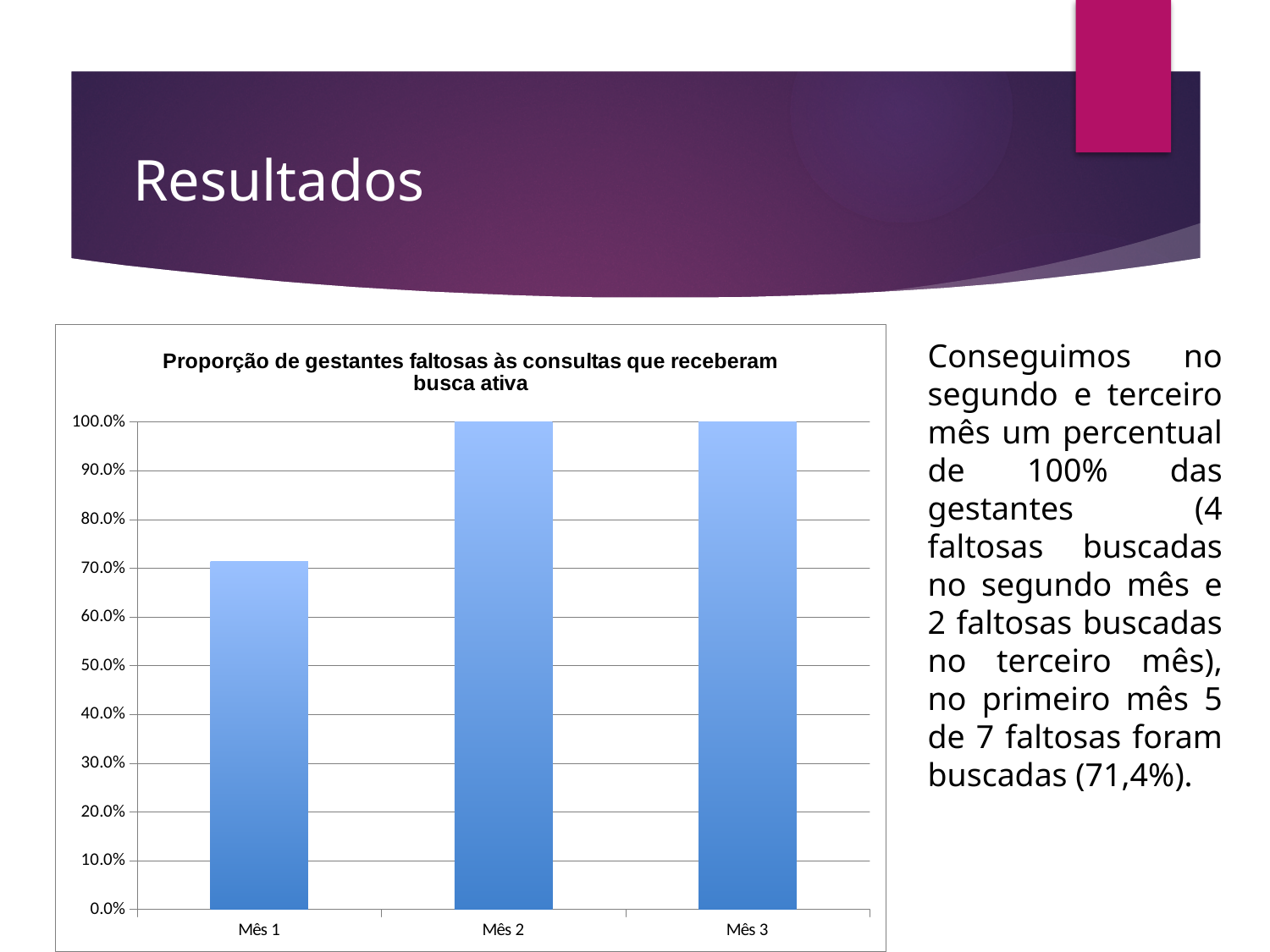
How many categories are shown on the x axis of the chart? 3 What is the value for Mês 3? 100.0% Is the value for Mês 1 greater or less than 80.0%? less Which month has the lowest value? Mês 1 What kind of chart is shown on the slide? bar chart What is the value for Mês 2? 100.0% What is the title of the chart? Proporção de gestantes faltosas às consultas que receberam busca ativa Is the value for Mês 1 greater or less than 70.0%? greater What is the highest value shown on the y axis of the chart? 100.0% What is the difference between the values for Mês 2 and Mês 3? 0.0% Does the value rise or fall from Mês 1 to Mês 2? rise Which is larger, the value for Mês 1 or the value for Mês 2? Mês 2